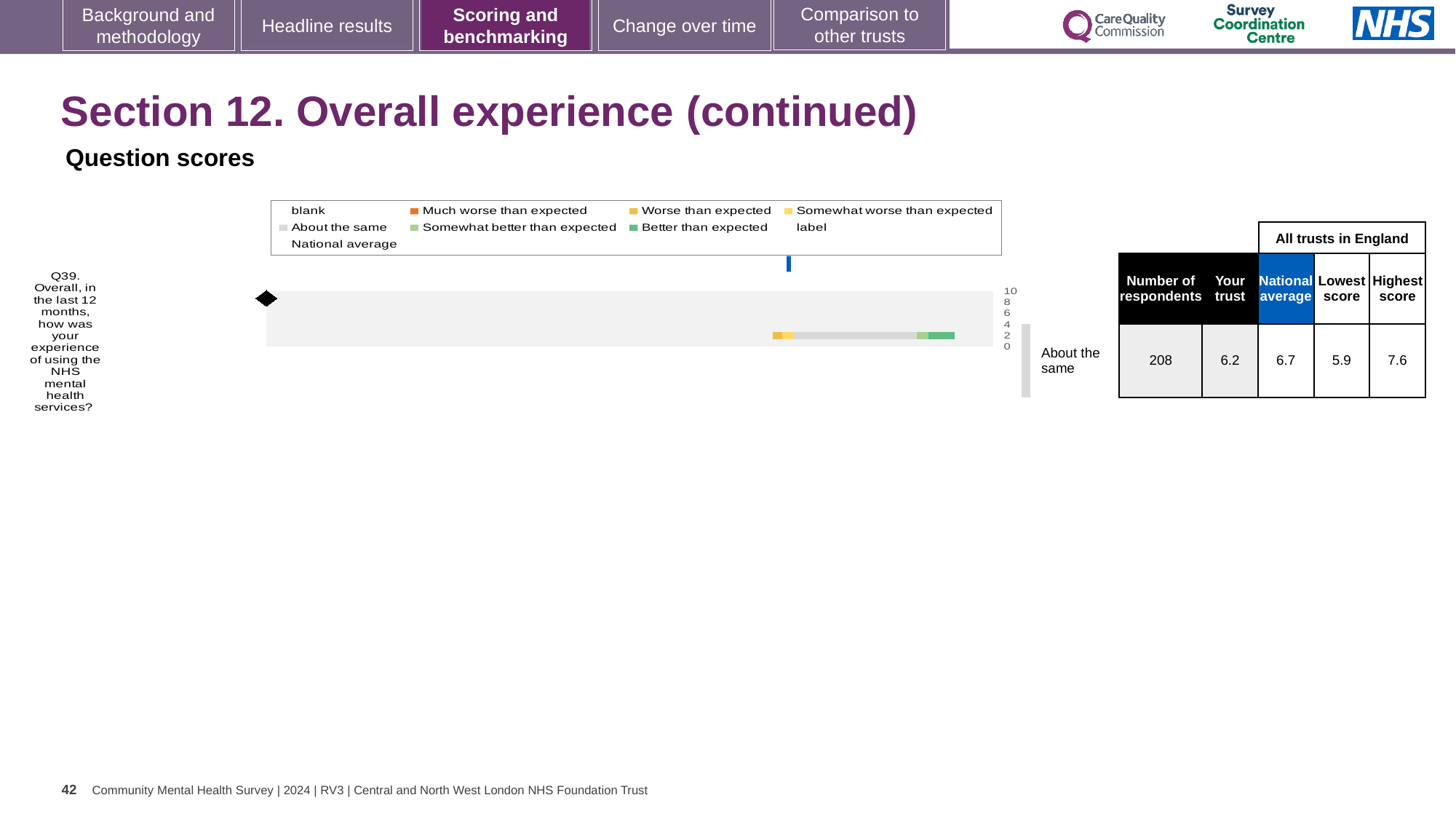
What is the 'Your trust' score for Q39? 6.2 Which question is shown on the chart? Q39. Overall, in the last 12 months, how was your experience of using the NHS mental health services? What is the difference between the national average and the trust's score for Q39? 0.5 How many respondents answered Q39? 208 What is the highest score among all trusts in England for Q39? 7.6 What kind of chart is used to show the Q39 question score? bar chart How many questions are plotted on the chart? 1 Which is larger for Q39, the trust's score or the national average? national average What is the difference between the highest and lowest scores among all trusts in England for Q39? 1.7 What is the lowest score among all trusts in England for Q39? 5.9 What is the national average score for Q39? 6.7 Which benchmarking category is the trust's Q39 score placed in? About the same